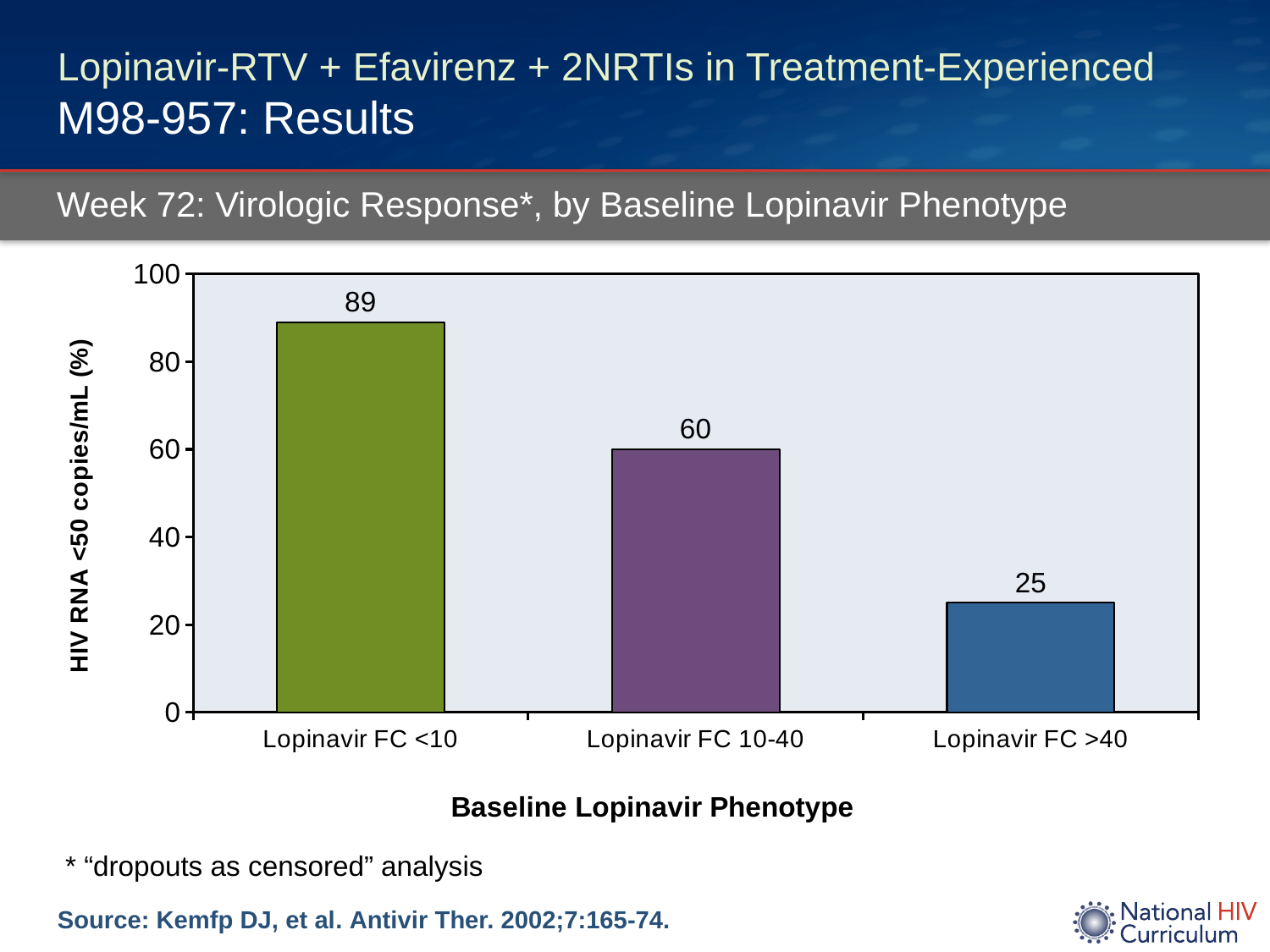
What is the difference between the values for Lopinavir FC <10 and Lopinavir FC >40? 64 What is the label of the y axis? HIV RNA <50 copies/mL (%) What is the value for Lopinavir FC 10-40? 60 Which category has the highest value? Lopinavir FC <10 What is the value for Lopinavir FC >40? 25 What kind of chart is shown on the slide? Bar chart Do the values rise or fall from left to right along the x axis? Fall What is the difference between the values for Lopinavir FC <10 and Lopinavir FC 10-40? 29 What is the value for Lopinavir FC <10? 89 Which is larger, the value for Lopinavir FC 10-40 or Lopinavir FC >40? Lopinavir FC 10-40 Which category has the lowest value? Lopinavir FC >40 How many categories are shown on the x axis? 3